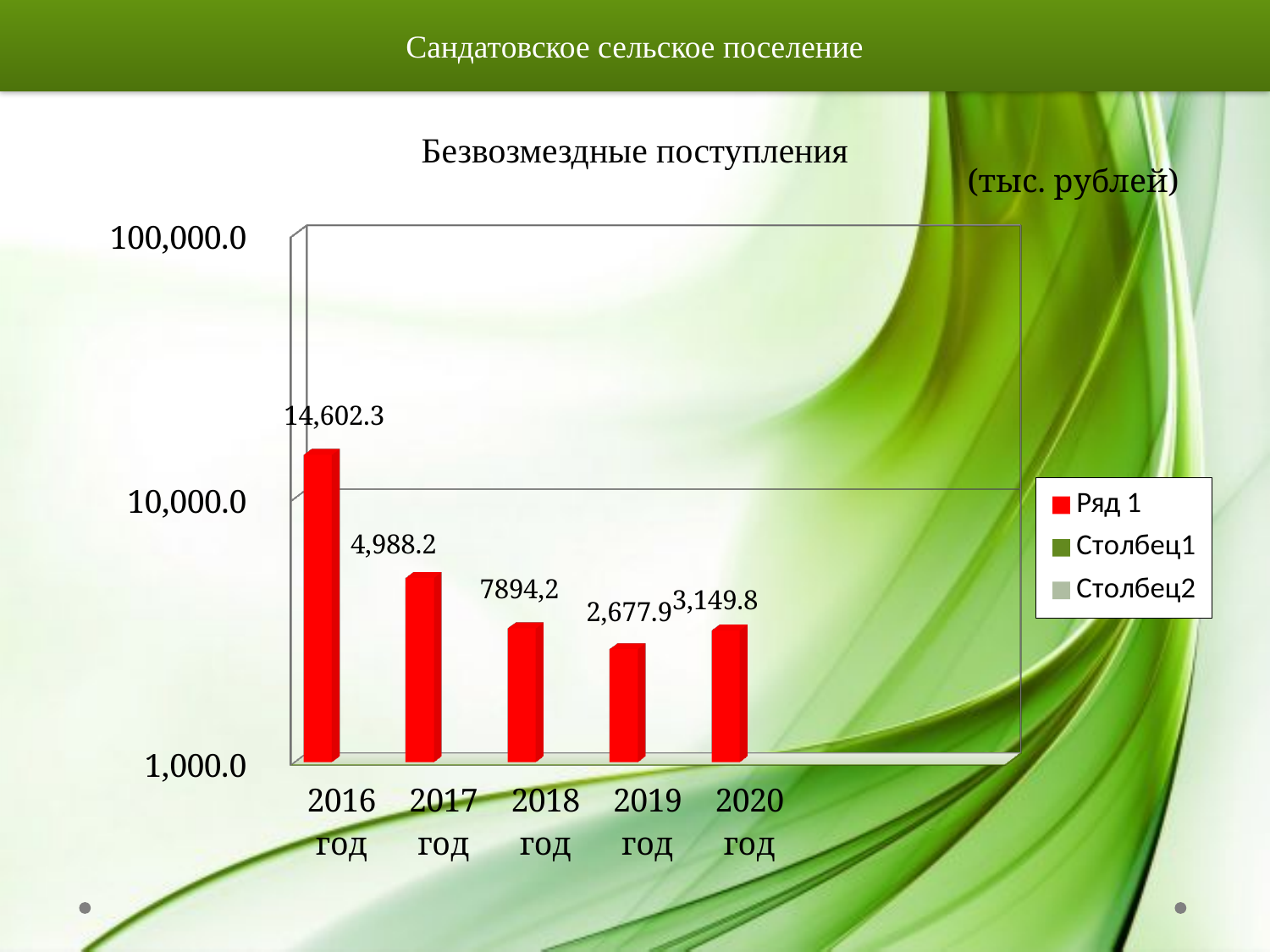
How many series does the legend list? 3 What kind of chart is shown? bar chart How many years are shown on the x axis? 5 What is the value for 2019 год? 2,677.9 Which year has the highest value? 2016 год What is the value for 2017 год? 4,988.2 What is the value for 2016 год? 14,602.3 Is the value for 2016 год greater or less than 10,000.0? greater What is the value for 2020 год? 3,149.8 What is the difference between the values for 2016 год and 2017 год? 9,614.1 Which year has the lowest value? 2019 год Which is larger, the value for 2017 год or the value for 2020 год? 2017 год